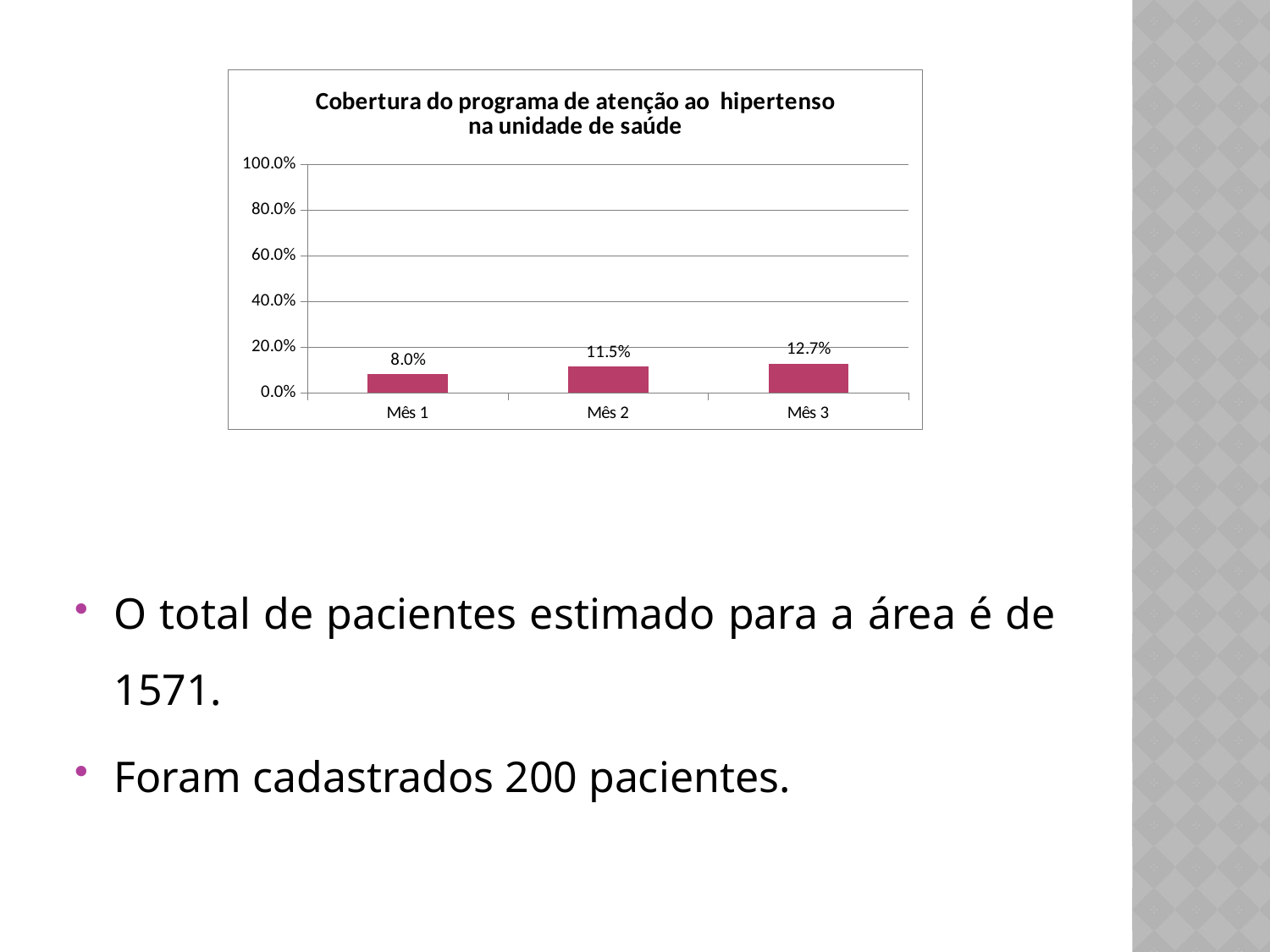
What is the difference between the values for Mês 3 and Mês 1? 4.7% How many months are shown on the x axis? 3 What is the value for Mês 2? 11.5% What is the difference between the values for Mês 2 and Mês 1? 3.5% Do the values rise or fall from Mês 1 to Mês 3? rise What kind of chart is shown? bar chart Which month has the highest value? Mês 3 Is the value for Mês 3 greater or less than 20.0%? less Which is larger, the value for Mês 2 or Mês 3? Mês 3 Which month has the lowest value? Mês 1 What is the value for Mês 3? 12.7% What is the value for Mês 1? 8.0%